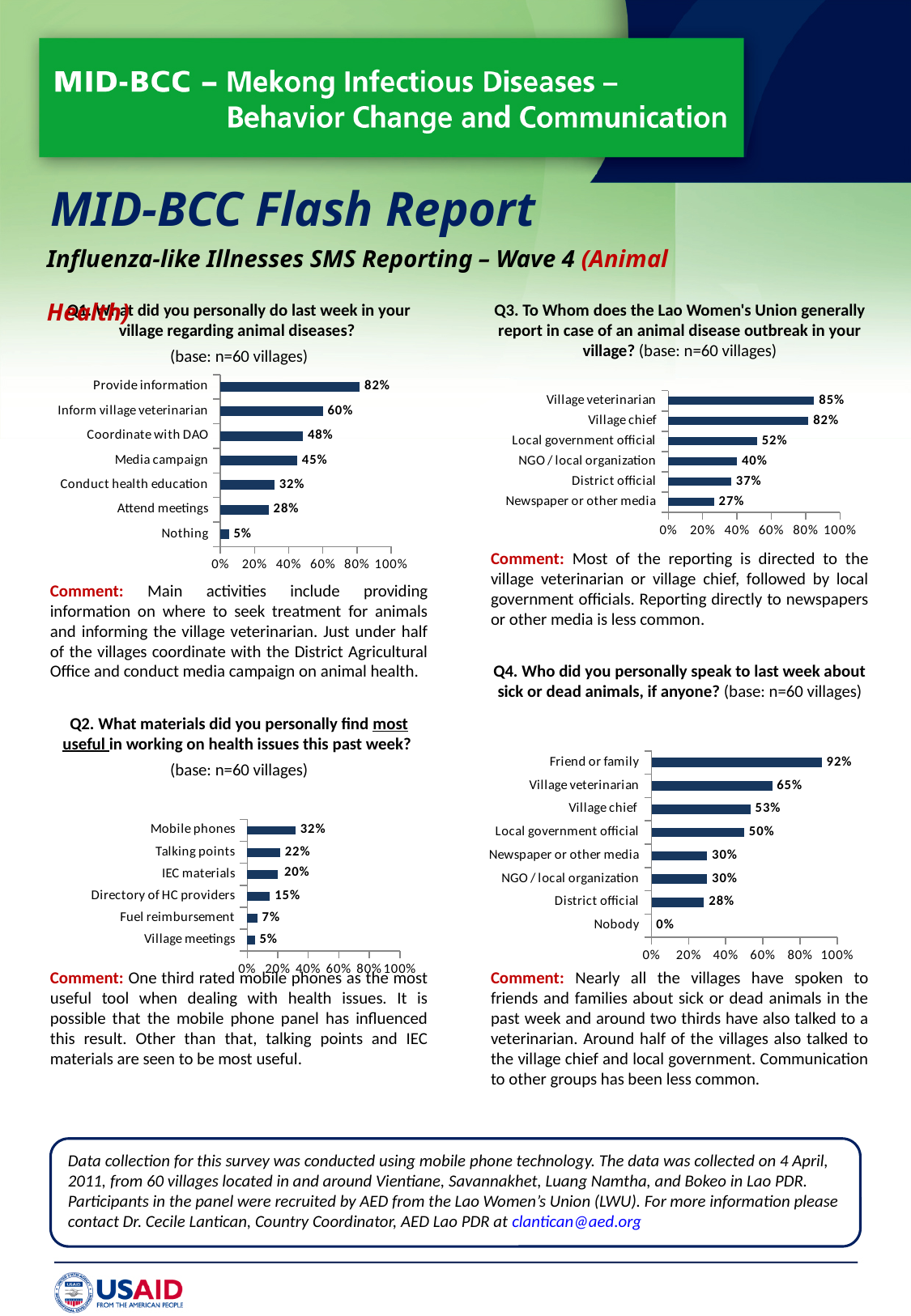
In the Q2 chart, which is larger: 'Directory of HC providers' or 'Fuel reimbursement'? Directory of HC providers In the Q1 chart (what villages did last week regarding animal diseases), what percentage is shown for 'Provide information'? 82% In the Q2 chart (most useful materials), what percentage is shown for 'Talking points'? 22% In the Q4 chart (who villages spoke to about sick or dead animals), what percentage is shown for 'Friend or family'? 92% How many categories are plotted in the Q1 chart? 7 In the Q3 chart, what is the difference between 'Village veterinarian' and 'Newspaper or other media'? 58% In the Q3 chart (to whom the Lao Women's Union reports), what percentage is shown for 'Local government official'? 52% What type of chart is used for Q4? Bar chart How many categories are plotted in the Q4 chart? 8 In the Q1 chart, which category has the lowest value? Nothing In the Q1 chart, what is the difference between 'Inform village veterinarian' and 'Coordinate with DAO'? 12% In the Q2 chart, which category has the highest value? Mobile phones